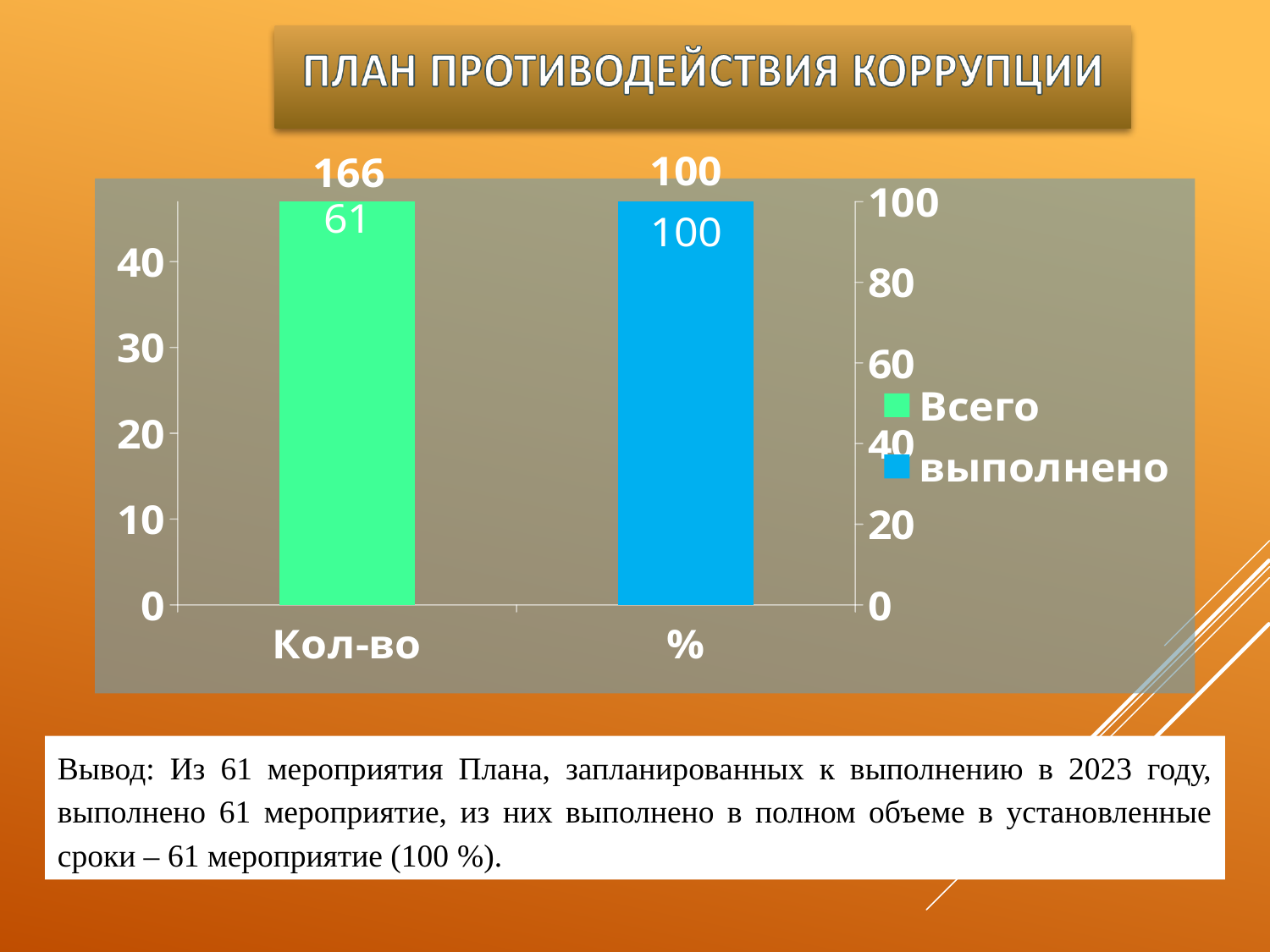
How many series does the legend list? 2 What kind of chart is shown on the slide? bar chart On the right axis, is the top of the % bar greater or less than 80? greater What number is printed above the Кол-во bar? 166 Which of the two bars has the larger labelled value, Кол-во (61) or %? % On the left axis, is the top of the Кол-во bar greater or less than 40? greater What is the title shown above the chart? ПЛАН ПРОТИВОДЕЙСТВИЯ КОРРУПЦИИ What number is printed inside the Кол-во bar? 61 What are the two entries in the chart legend? Всего, выполнено How many bars (categories) are plotted in the chart? 2 What value is labelled on the % bar? 100